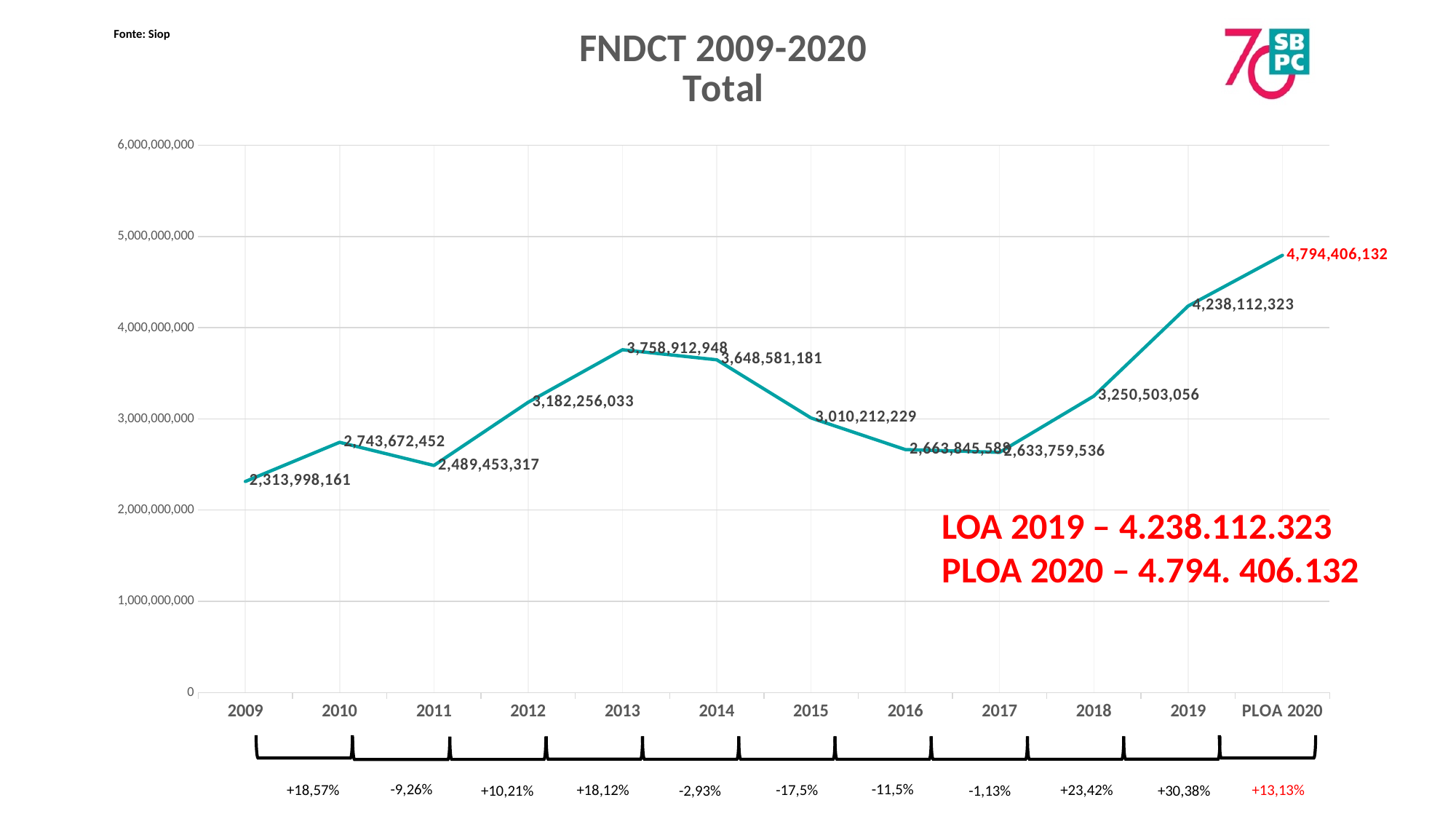
Which year has the lowest value? 2009 What kind of chart is shown on the slide? line chart Is the value for 2012 greater or less than 3,000,000,000? greater Which year or point on the x axis has the highest value? PLOA 2020 How many data points are plotted on the line? 12 Do the values rise or fall from 2013 to 2017? fall What is the value shown for PLOA 2020? 4,794,406,132 Which is larger, the value for 2013 or the value for 2014? 2013 What is the difference between the PLOA 2020 value and the 2019 value? 556,293,809 What is the FNDCT total value for 2013? 3,758,912,948 What is the FNDCT total value for 2009? 2,313,998,161 What percentage change is shown between 2018 and 2019 below the chart? +30,38%